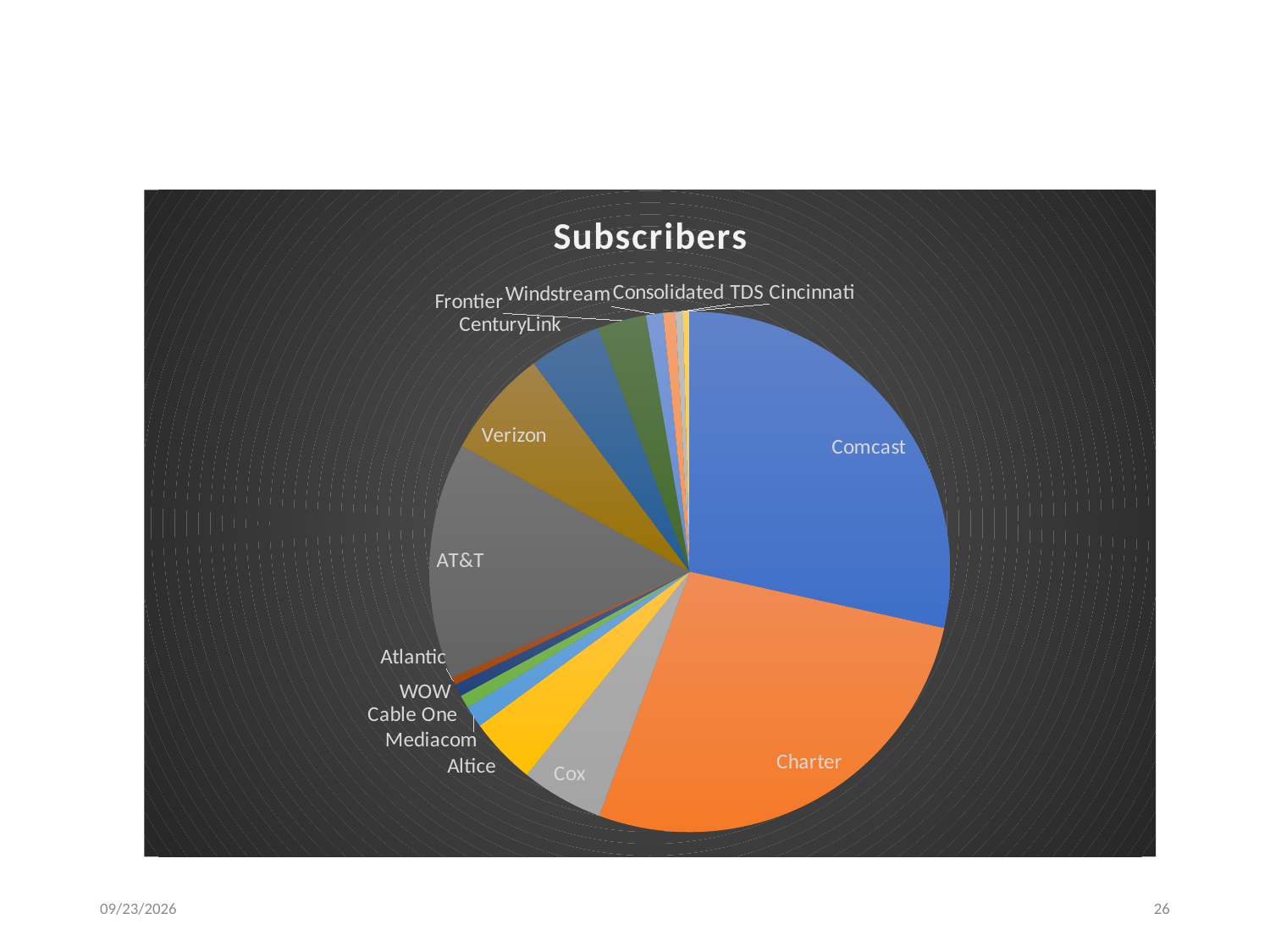
Which is larger, the slice for Verizon or the slice for CenturyLink? Verizon Which is larger, the slice for AT&T or the slice for Frontier? AT&T What is the title of the chart? Subscribers What kind of chart is shown on the slide? pie chart Which is larger, the slice for Comcast or the slice for Charter? Comcast Which category has the largest slice of the pie? Comcast What colour is the Comcast slice? blue How many categories (slices) are labelled in the pie chart? 16